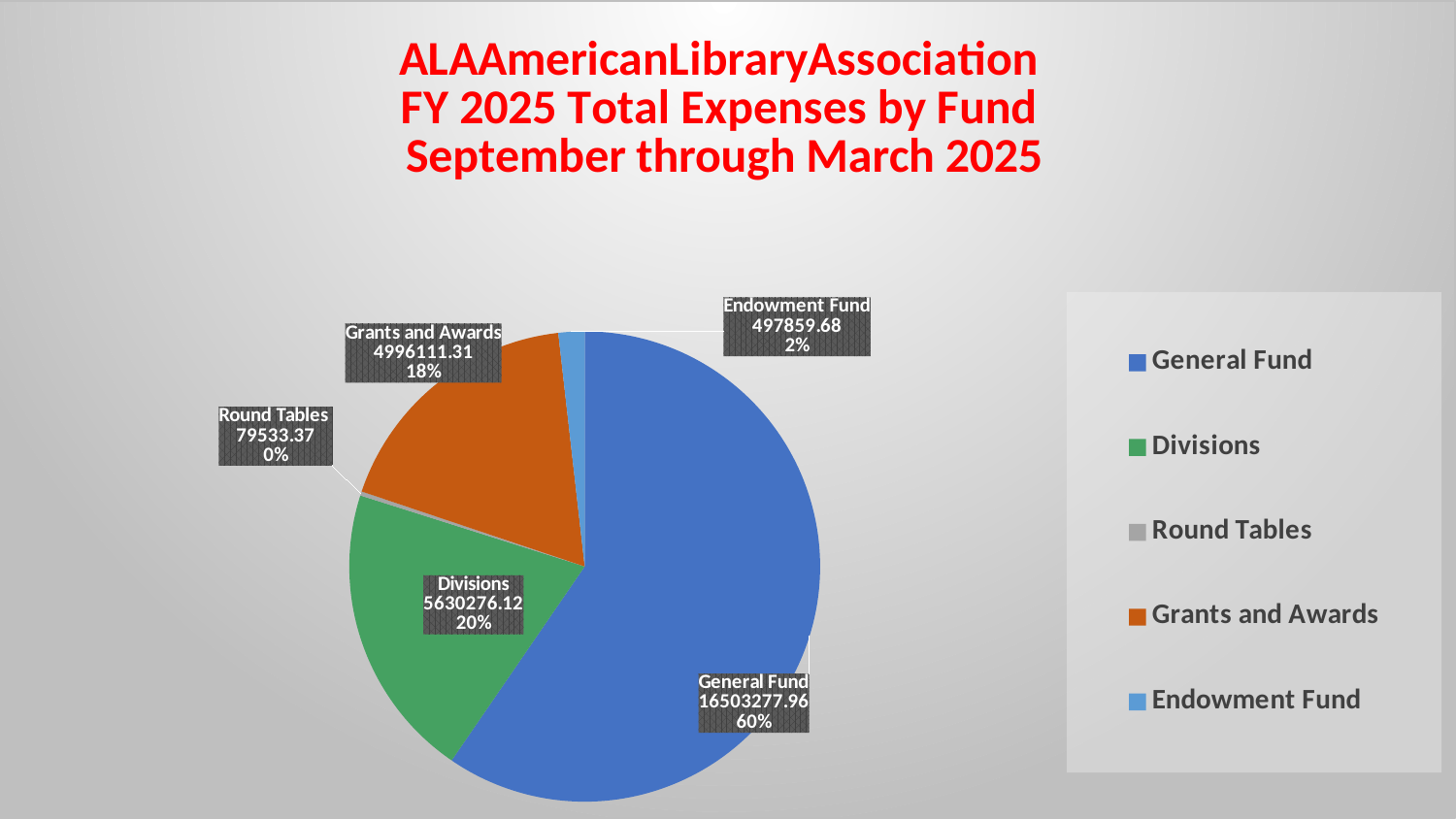
What type of chart is shown on the slide? Pie chart Which fund has the smallest expenses? Round Tables What share of the pie does the Grants and Awards slice represent? 18% Which fund has the largest expenses? General Fund What is the value for Divisions? 5630276.12 What is the value for Grants and Awards? 4996111.31 How many funds are shown in the legend? 5 What is the value for the General Fund slice? 16503277.96 What is the difference between the General Fund and Divisions values? 10873001.84 Which is larger, Divisions or Grants and Awards? Divisions What share of the pie does the Divisions slice represent? 20% What is the value for the Endowment Fund? 497859.68